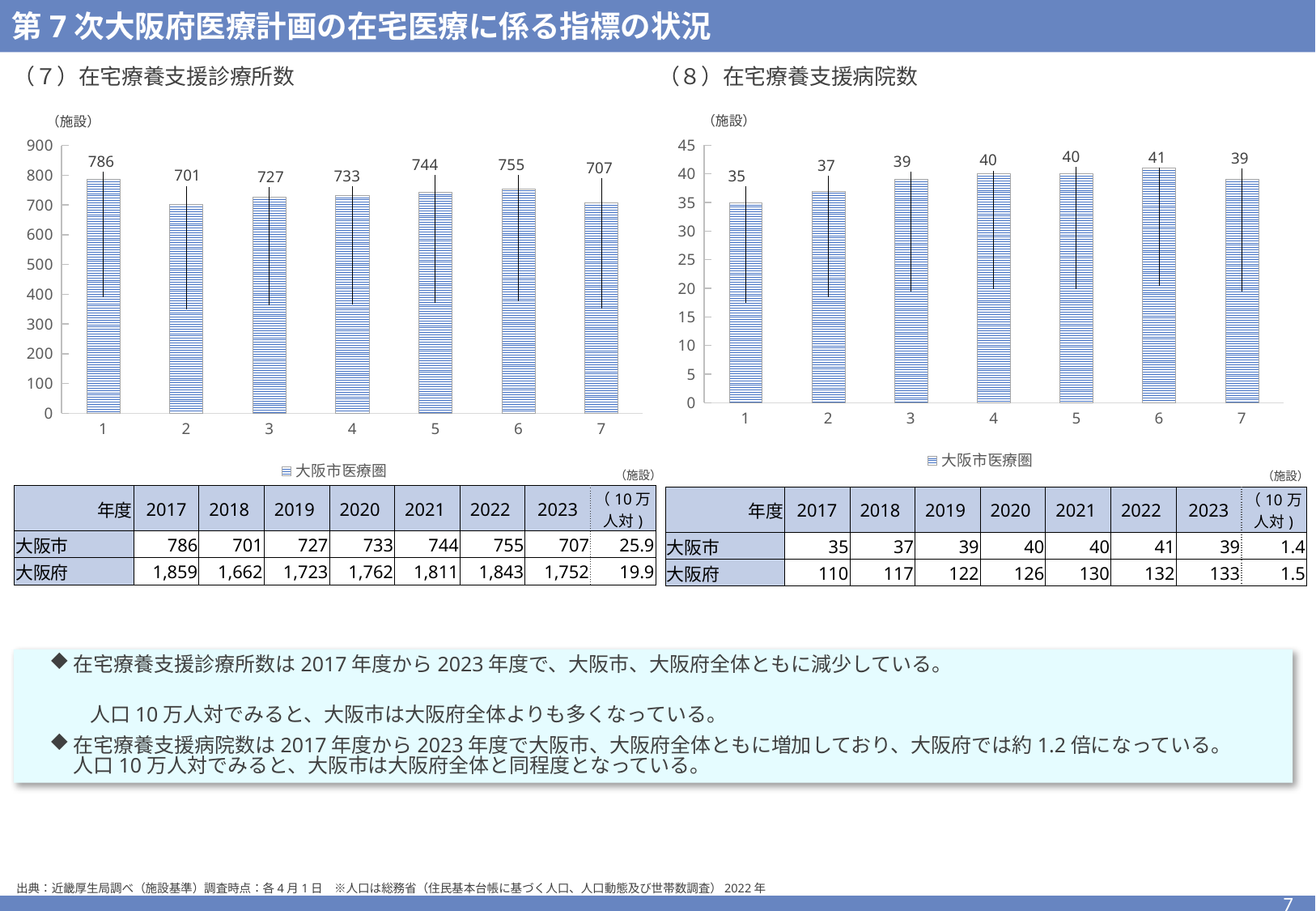
In the chart titled （7）在宅療養支援診療所数, which category has the highest value? 1 In the chart titled （8）在宅療養支援病院数, which category has the lowest value? 1 In the chart titled （8）在宅療養支援病院数, which category has the highest value? 6 In the chart titled （7）在宅療養支援診療所数, which category has the lowest value? 2 In the chart titled （7）在宅療養支援診療所数, what is the difference between the values for category 1 and category 2? 85 In the chart titled （8）在宅療養支援病院数, is the value for category 3 larger than the value for category 1? Yes In the chart titled （8）在宅療養支援病院数, what series name does the legend show? 大阪市医療圏 What kind of chart is the chart titled （7）在宅療養支援診療所数? Bar chart In the chart titled （7）在宅療養支援診療所数, what is the value for category 1? 786 In the chart titled （8）在宅療養支援病院数, what is the value for category 6? 41 In the chart titled （8）在宅療養支援病院数, what is the difference between the values for category 6 and category 1? 6 In the chart titled （7）在宅療養支援診療所数, how many bars are plotted? 7